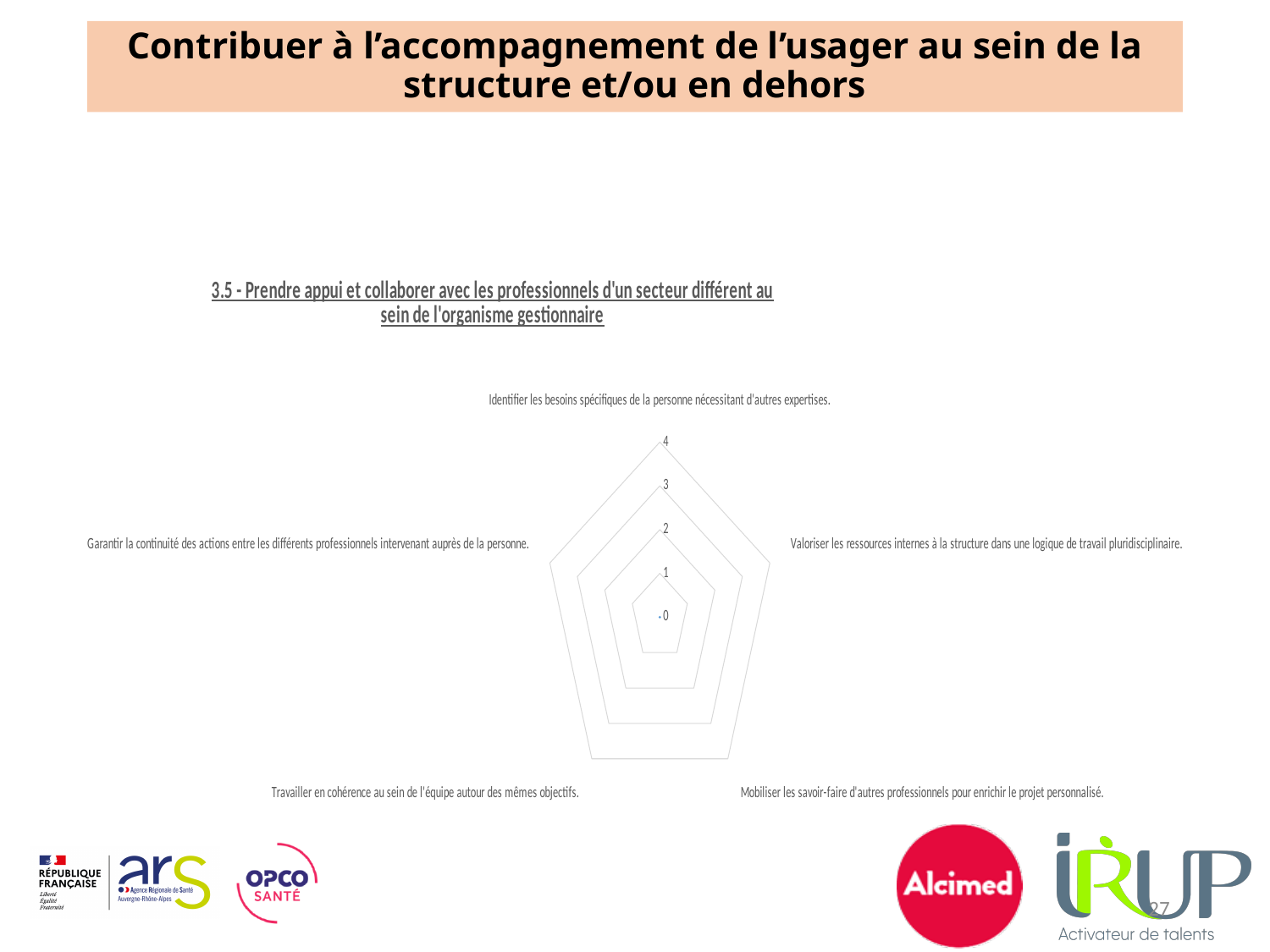
What is the highest value shown on the radar chart's scale? 4 Which category label appears on the left side of the radar chart? Garantir la continuité des actions entre les différents professionnels intervenant auprès de la personne. How many categories (axes) does the radar chart have? 5 Which category label appears at the bottom right of the radar chart? Mobiliser les savoir-faire d'autres professionnels pour enrichir le projet personnalisé. What kind of chart is shown on the slide? Radar chart Which category label appears at the bottom left of the radar chart? Travailler en cohérence au sein de l'équipe autour des mêmes objectifs. Which category label appears on the right side of the radar chart? Valoriser les ressources internes à la structure dans une logique de travail pluridisciplinaire. What is the lowest value shown on the radar chart's scale? 0 What is the title of the radar chart? 3.5 - Prendre appui et collaborer avec les professionnels d'un secteur différent au sein de l'organisme gestionnaire Which category label appears at the top of the radar chart? Identifier les besoins spécifiques de la personne nécessitant d'autres expertises.